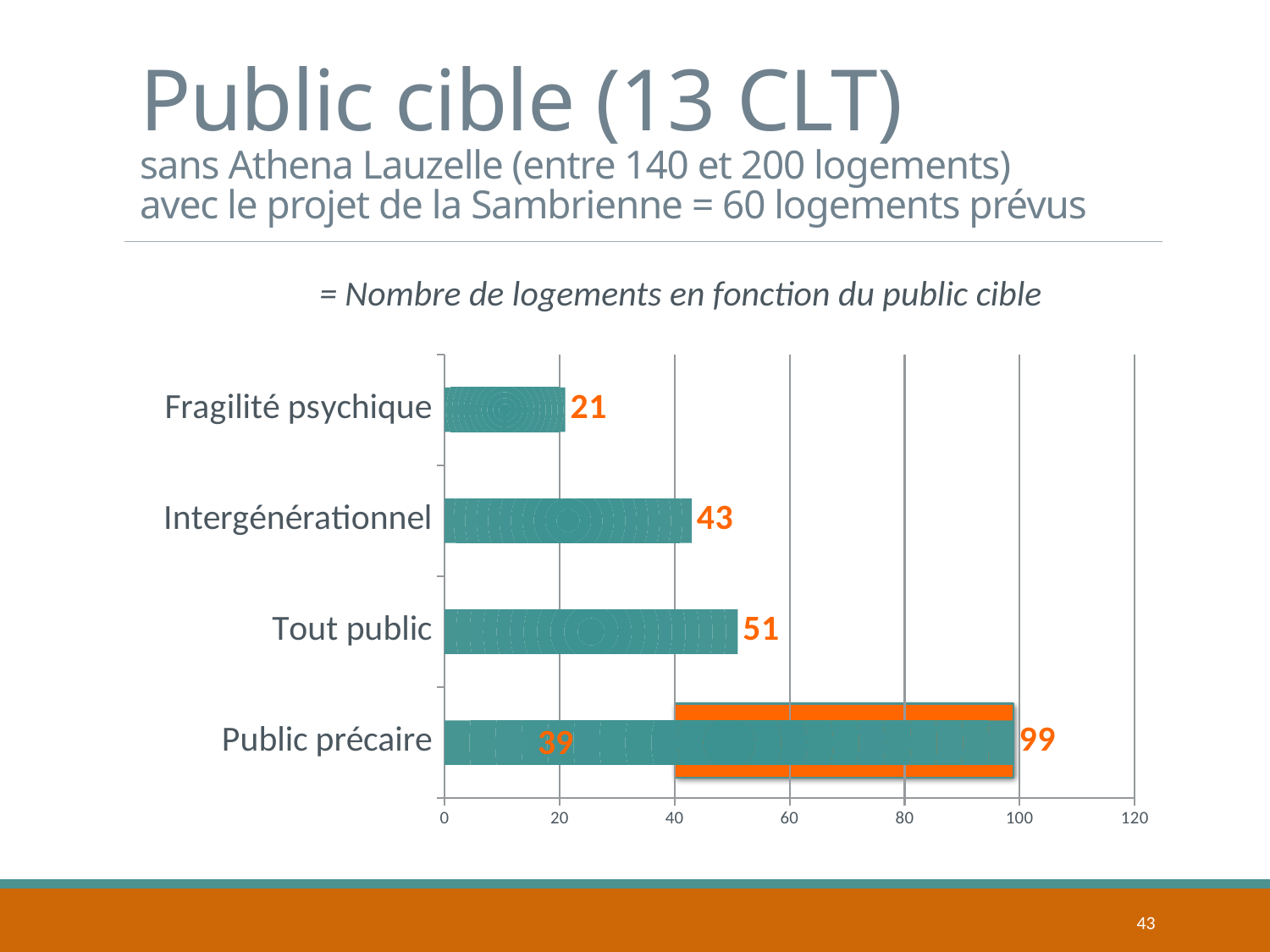
What is the difference between the values for Public précaire and Fragilité psychique? 78 Which category has the lowest value? Fragilité psychique Which is larger, the value for Intergénérationnel or the value for Tout public? Tout public How many categories are shown on the chart? 4 What is the total value shown at the end of the Public précaire bar? 99 Is the value for Tout public greater or less than 60? less Which category has the highest value? Public précaire What is the value for Fragilité psychique? 21 What is the value for Tout public? 51 What is the difference between the values for Tout public and Intergénérationnel? 8 What kind of chart is shown on the slide? bar chart What is the value for Intergénérationnel? 43